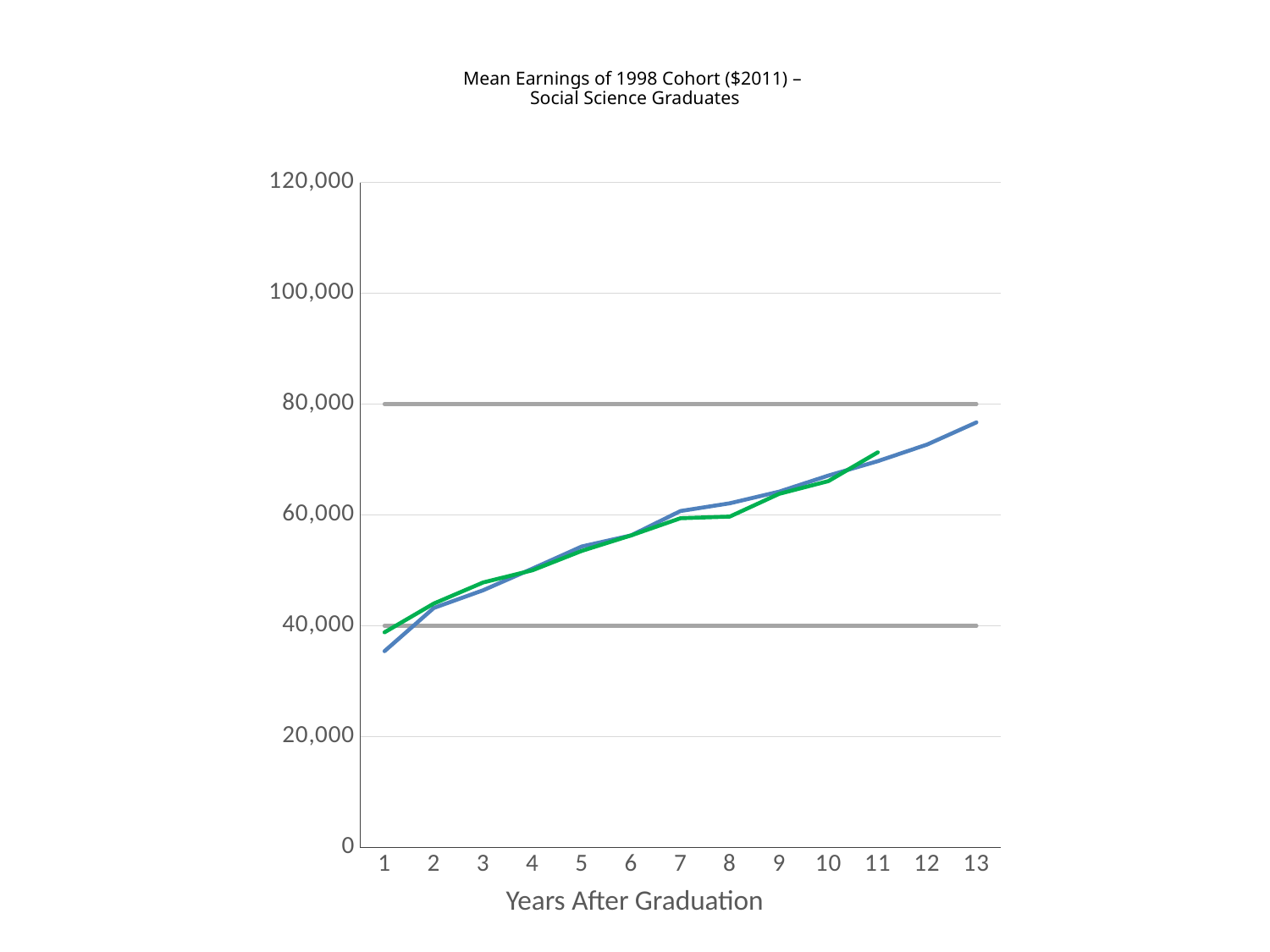
At which year after graduation does the blue line reach its highest value? 13 At what value is the upper gray horizontal line drawn? 80,000 What kind of chart is shown on the slide? line chart What is the title of the chart? Mean Earnings of 1998 Cohort ($2011) – Social Science Graduates Is the value of the blue line at year 4 greater or less than 60,000? less Do the blue and green lines rise or fall as years after graduation increase? rise At what value is the lower gray horizontal line drawn? 40,000 Is the value of the blue line at year 1 greater or less than 40,000? less What is the label of the x axis? Years After Graduation Is the value of the green line at year 11 greater or less than 60,000? greater How many years after graduation are marked on the x axis? 13